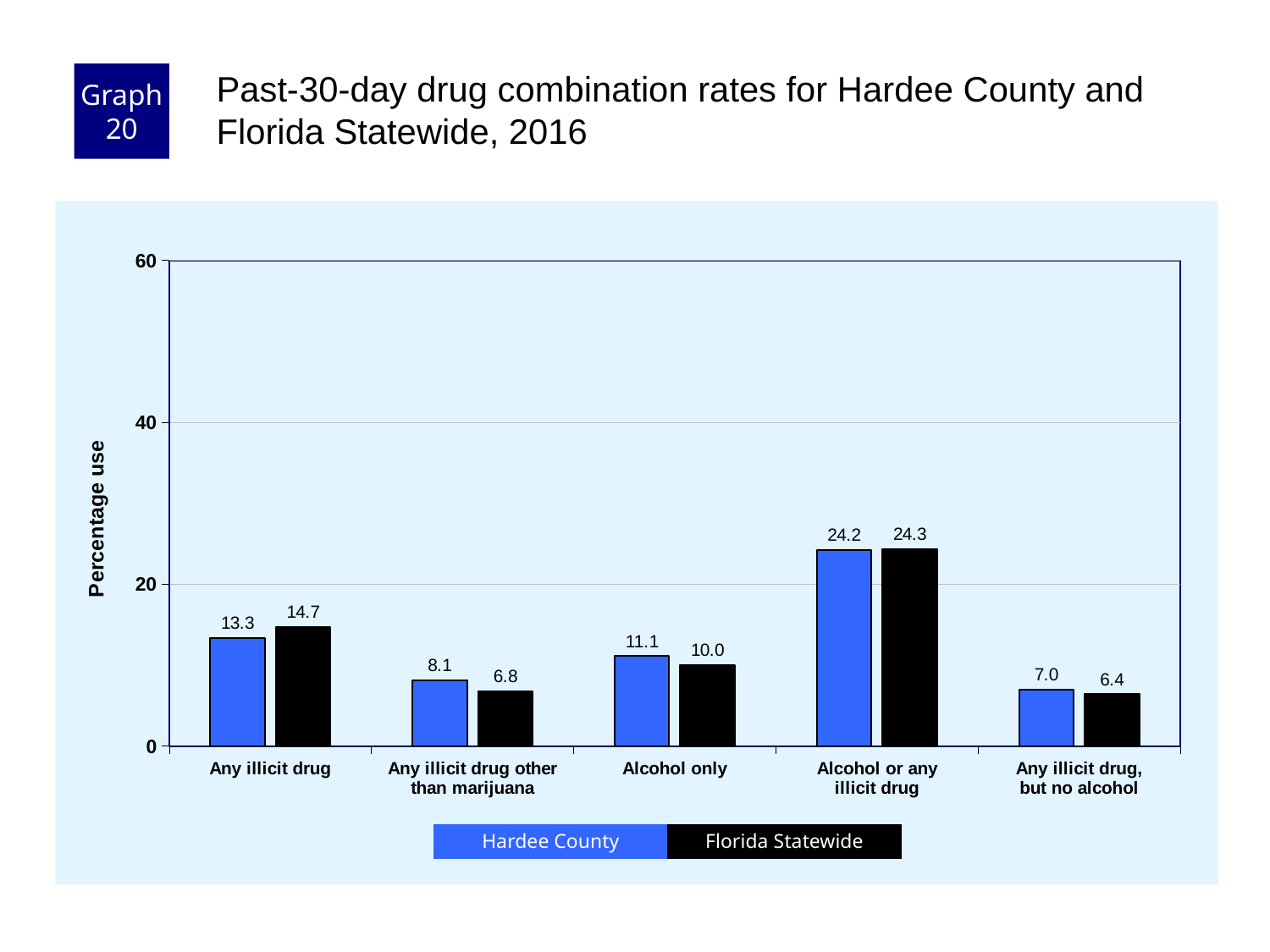
What is the Florida Statewide value for Alcohol only? 10.0 What is the Florida Statewide value for Any illicit drug, but no alcohol? 6.4 Which category has the lowest Florida Statewide value? Any illicit drug, but no alcohol What is the difference between the Florida Statewide and Hardee County values for Any illicit drug? 1.4 How many categories are shown on the x axis? 5 What kind of chart is shown on the slide? Bar chart Which category has the highest Hardee County value? Alcohol or any illicit drug How many series does the legend list? 2 What is the Hardee County value for Any illicit drug? 13.3 For Alcohol only, which is larger: Hardee County or Florida Statewide? Hardee County Is the Florida Statewide value for Alcohol or any illicit drug greater or less than 20? greater What is the difference between the Hardee County and Florida Statewide values for Any illicit drug other than marijuana? 1.3